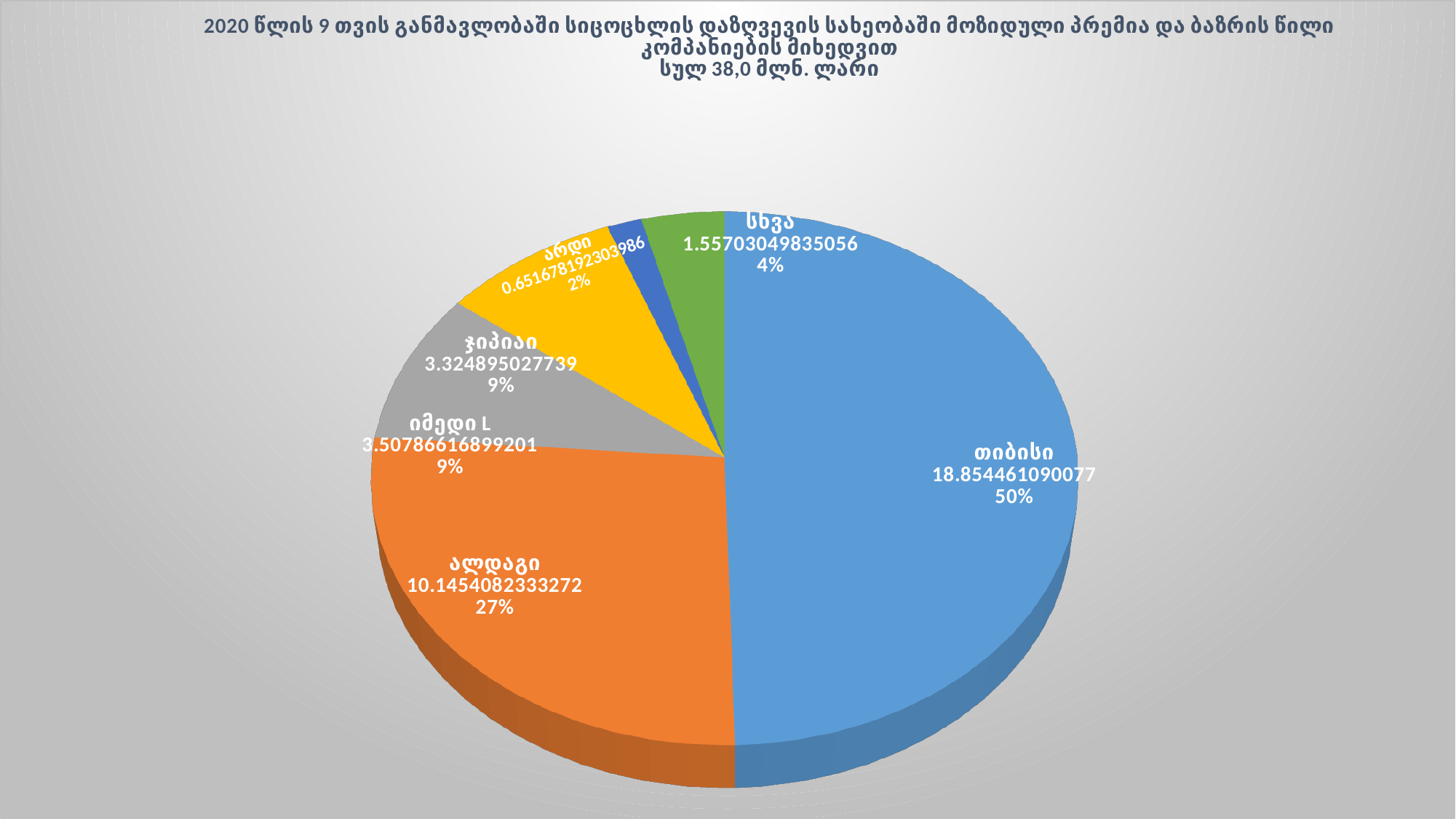
What value is shown for თიბისი? 18.854461090077 What share of the pie does ალდაგი hold? 27% What share of the pie does არდი hold? 2% Which category has the largest slice of the pie? თიბისი What value is shown for სხვა? 1.55703049835056 According to the chart title, what is the total amount in million lari? 38,0 მლნ. ლარი What share of the pie does თიბისი hold? 50% What value is shown for ალდაგი? 10.1454082333272 How many slices does the pie chart have? 6 Which is larger, the value for ალდაგი or the value for ჯიპიაი? ალდაგი What kind of chart is shown on the slide? pie chart Which category has the smallest slice of the pie? არდი